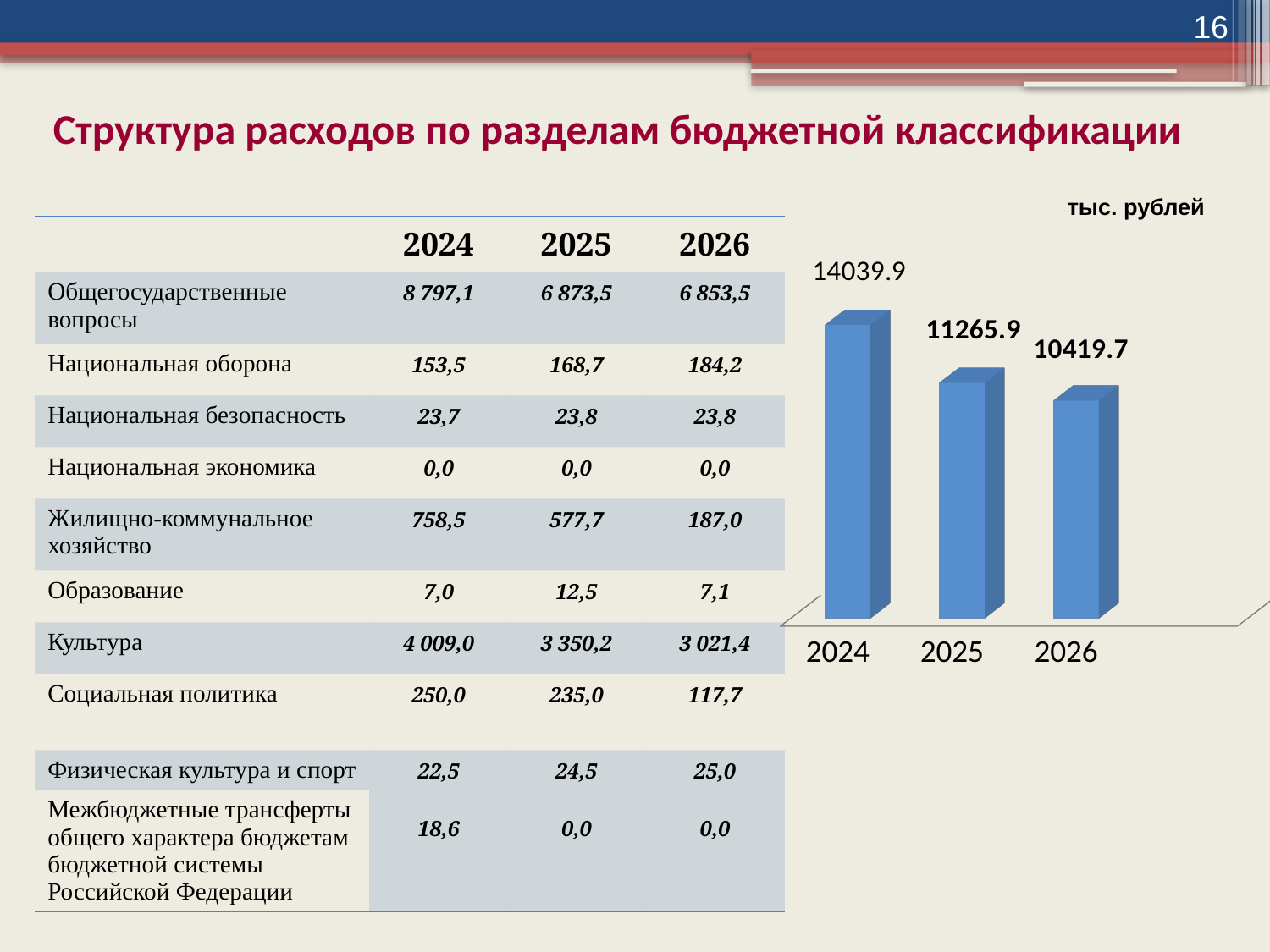
On the bar chart, which is larger: the value for 2025 or the value for 2026? 2025 What is the difference between the 2025 and 2026 values on the bar chart? 846.2 How many bars are shown on the bar chart? 3 What is the value shown for 2026 on the bar chart? 10419.7 What is the difference between the 2024 and 2025 values on the bar chart? 2774.0 What is the value shown for 2025 on the bar chart? 11265.9 Which year has the highest value on the bar chart? 2024 What type of chart is shown on the right side of the slide? bar chart Do the values on the bar chart rise or fall from 2024 to 2026? fall Which year has the lowest value on the bar chart? 2026 What is the value shown for 2024 on the bar chart? 14039.9 What unit is indicated above the bar chart? тыс. рублей